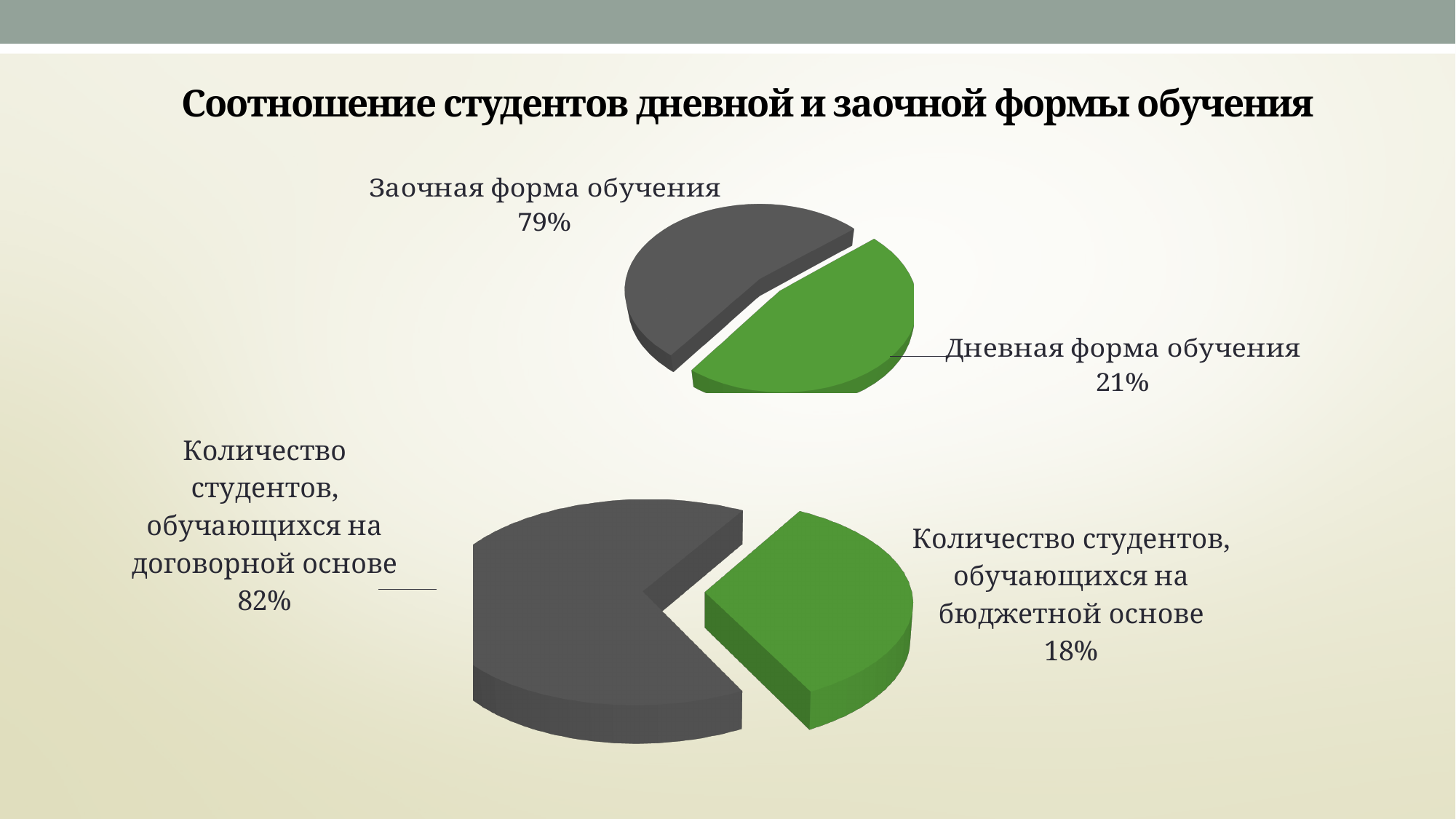
What type of chart is the bottom chart on the slide? Pie chart On the bottom pie chart, what is the difference in percentage points between the contract-basis and budget-basis slices? 64 On the top pie chart, what is the difference in percentage points between Заочная форма обучения and Дневная форма обучения? 58 On the top pie chart, what share is labelled for Дневная форма обучения? 21% On the bottom pie chart, what share is labelled for students studying on a contract basis (договорной основе)? 82% On the top pie chart, which slice is the largest? Заочная форма обучения What is the title of the slide above the charts? Соотношение студентов дневной и заочной формы обучения On the top pie chart, which slice is the smallest? Дневная форма обучения On the bottom pie chart, which slice is larger: договорной основе or бюджетной основе? договорной основе On the bottom pie chart, what share is labelled for students studying on a budget basis (бюджетной основе)? 18% On the top pie chart, what share is labelled for Заочная форма обучения? 79% On the top pie chart, how many slices are there? 2